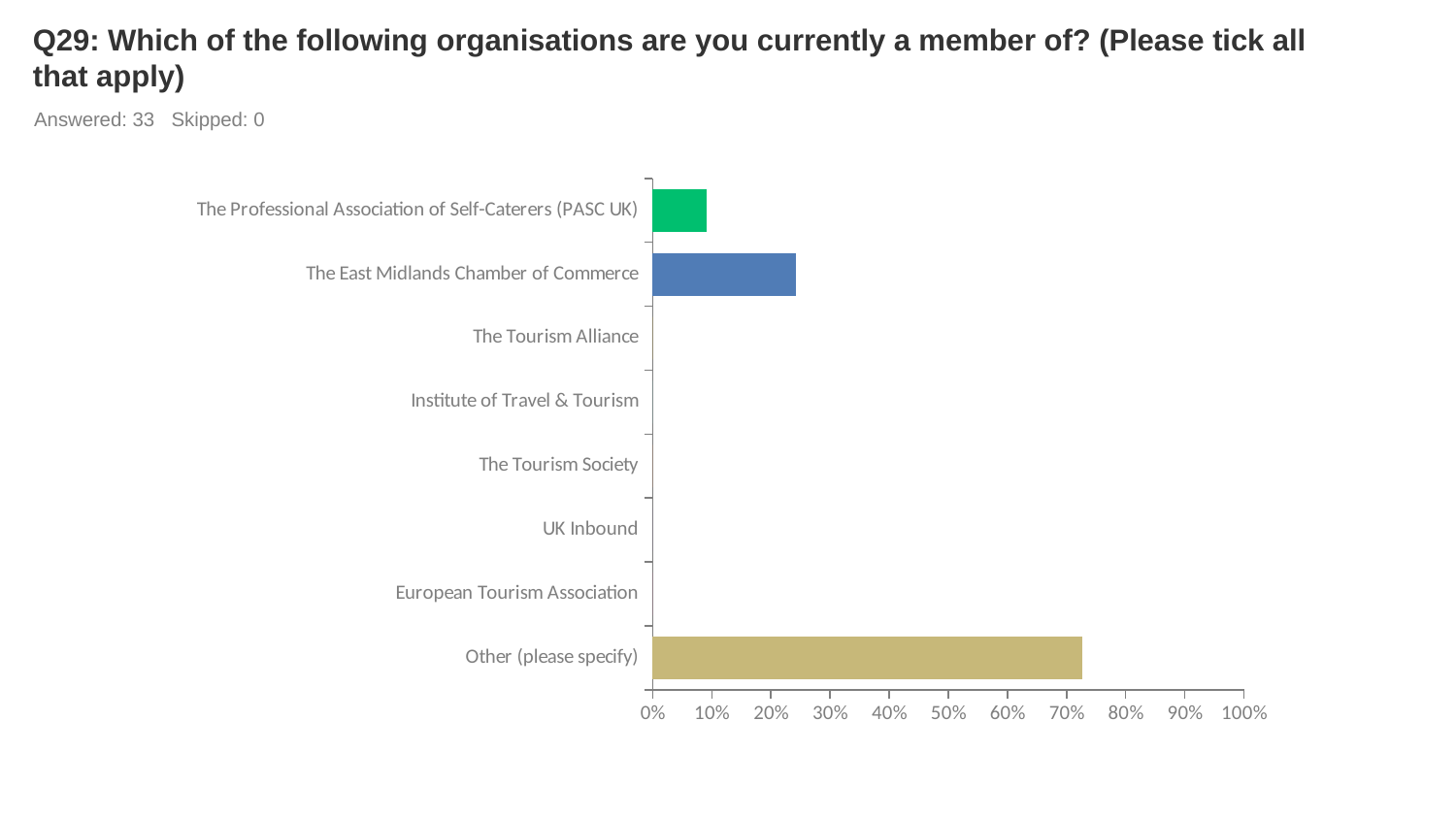
How many respondents answered this question according to the slide? 33 Which has the larger value: Other (please specify) or The East Midlands Chamber of Commerce? Other (please specify) Which has the larger value: The East Midlands Chamber of Commerce or The Professional Association of Self-Caterers (PASC UK)? The East Midlands Chamber of Commerce Is the value for The East Midlands Chamber of Commerce greater or less than 30%? less Is the value for Other (please specify) greater or less than 60%? greater Is the value for The Professional Association of Self-Caterers (PASC UK) greater or less than 20%? less How many organisations (categories) are listed on the chart? 8 What kind of chart is shown on the slide? bar chart Which organisation has the highest value on the chart? Other (please specify) What is the maximum value shown on the horizontal axis? 100%